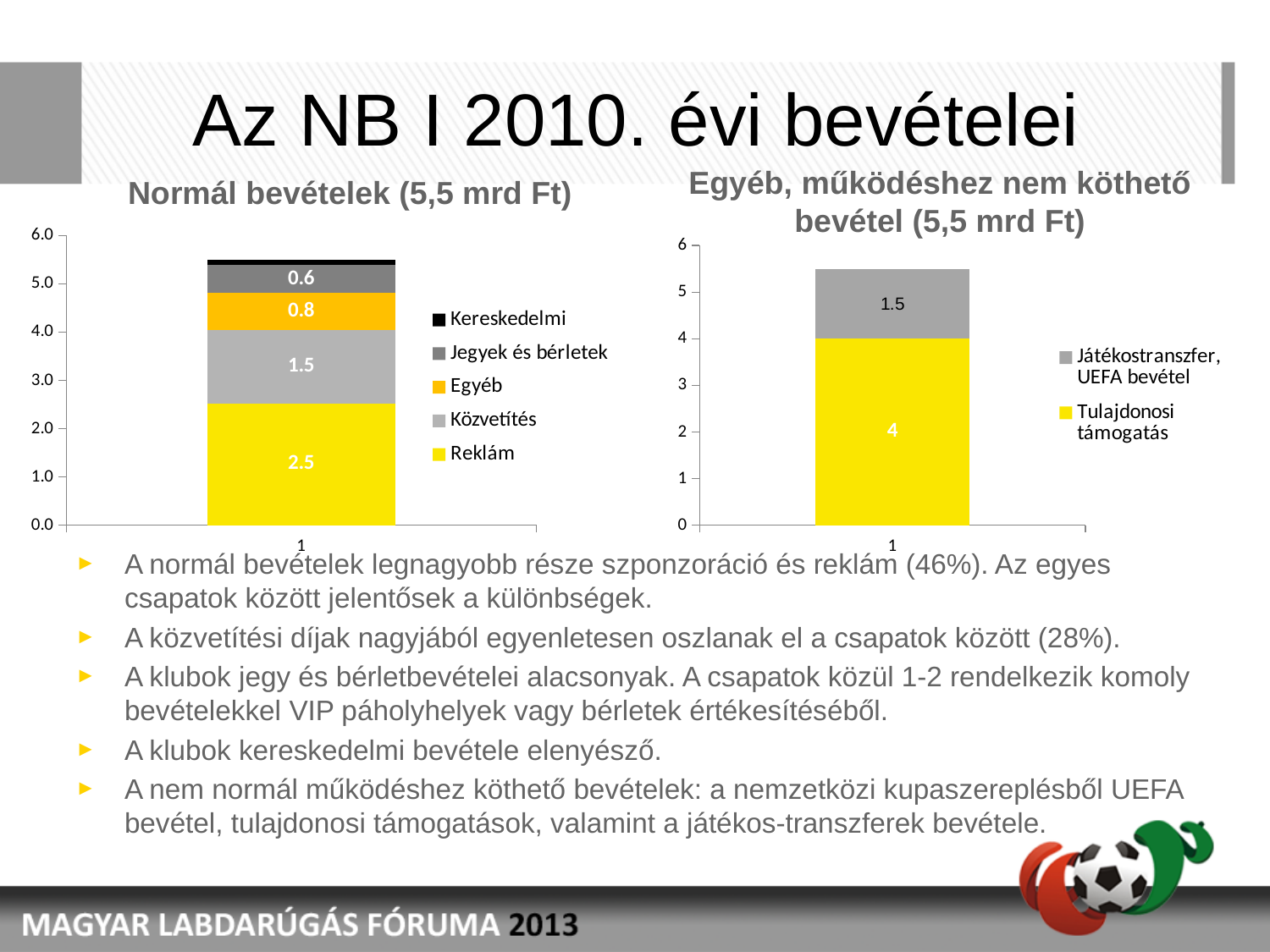
In the chart titled "Normál bevételek (5,5 mrd Ft)", which labelled segment is the largest? Reklám In the chart titled "Normál bevételek (5,5 mrd Ft)", is the Egyéb segment larger or smaller than the Jegyek és bérletek segment? larger In the chart titled "Normál bevételek (5,5 mrd Ft)", what is the value of the Reklám segment? 2.5 In the chart titled "Normál bevételek (5,5 mrd Ft)", what is the value of the Jegyek és bérletek segment? 0.6 In the chart titled "Egyéb, működéshez nem köthető bevétel (5,5 mrd Ft)", what is the value of the Játékostranszfer, UEFA bevétel segment? 1.5 In the chart titled "Egyéb, működéshez nem köthető bevétel (5,5 mrd Ft)", what is the total of the stacked bar? 5.5 In the chart titled "Normál bevételek (5,5 mrd Ft)", how many series does the legend list? 5 In the chart titled "Egyéb, működéshez nem köthető bevétel (5,5 mrd Ft)", what is the value of the Tulajdonosi támogatás segment? 4 In the chart titled "Egyéb, működéshez nem köthető bevétel (5,5 mrd Ft)", how many series does the legend list? 2 What kind of chart is the one on the right of the slide? stacked bar chart In the chart titled "Normál bevételek (5,5 mrd Ft)", what is the value of the Közvetítés segment? 1.5 In the chart titled "Normál bevételek (5,5 mrd Ft)", what is the difference between the Reklám and Egyéb segments? 1.7